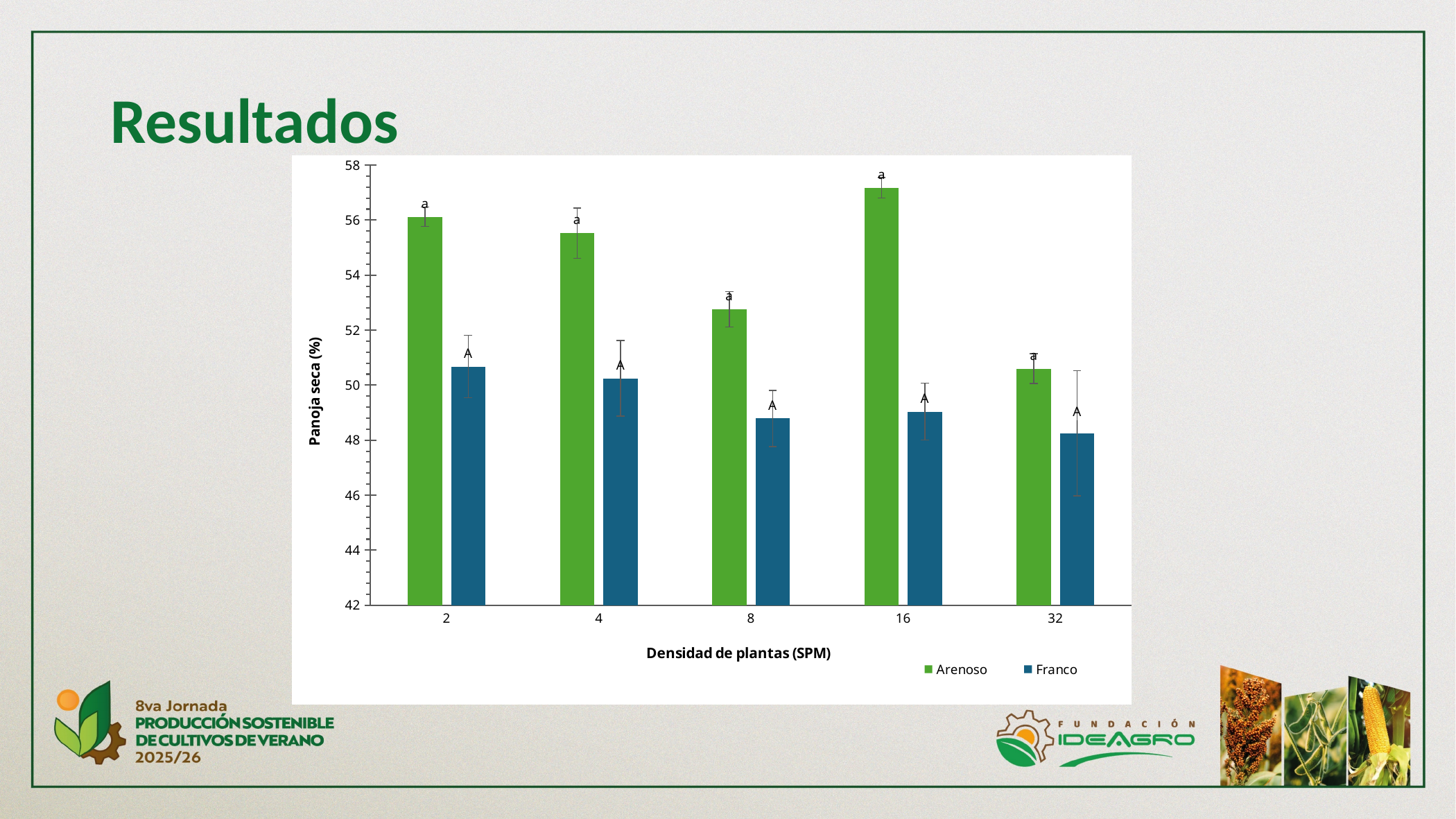
Which series is shown in green in the legend? Arenoso Is the Franco value at density 8 greater or less than 50? less How many series does the legend list? 2 At which plant density is the Arenoso value highest? 16 At which plant density is the Arenoso value lowest? 32 Is the Franco value at density 32 greater or less than 46? greater What kind of chart is shown on the slide? bar chart How many plant density categories are shown on the x axis? 5 Is the Arenoso value at density 8 greater or less than 54? less What is the label of the y axis? Panoja seca (%) At a density of 8, which is larger, Arenoso or Franco? Arenoso